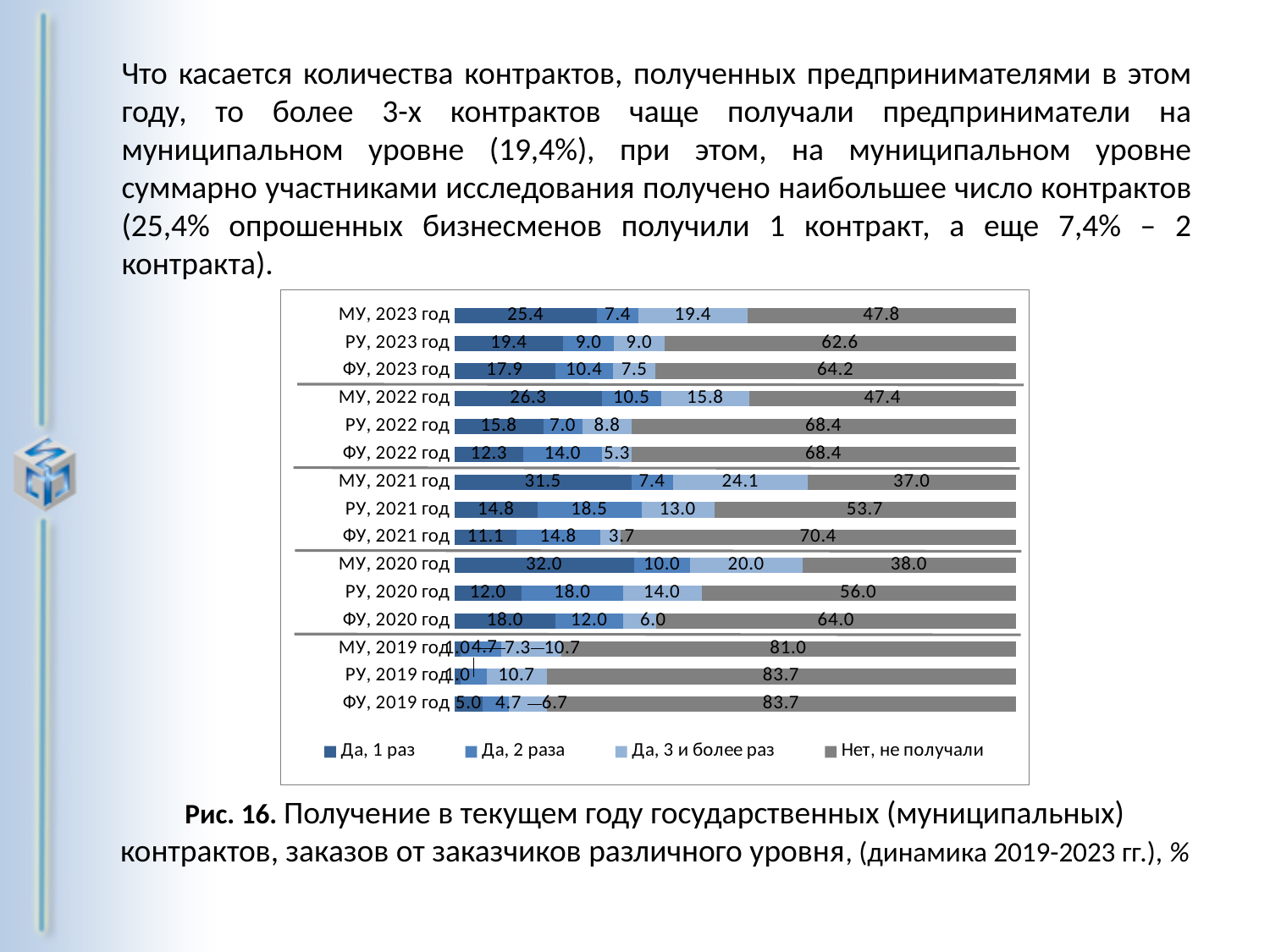
What is the difference between the "Да, 1 раз" values for МУ, 2023 год and РУ, 2023 год? 6.0 What is the value of "Да, 3 и более раз" for МУ, 2021 год? 24.1 Which has the larger "Нет, не получали" value: РУ, 2023 год or ФУ, 2023 год? ФУ, 2023 год Which category has the highest value for "Да, 1 раз"? МУ, 2020 год How many series does the legend list? 4 What is the value of "Нет, не получали" for МУ, 2023 год? 47.8 What kind of chart is shown on the slide? Stacked bar chart What is the value of "Да, 1 раз" for МУ, 2020 год? 32.0 What is the total of the stacked bar for МУ, 2023 год? 100.0 What is the value of "Да, 2 раза" for ФУ, 2022 год? 14.0 Which category has the lowest value for "Нет, не получали"? МУ, 2021 год How many categories (bars) are shown in the chart? 15